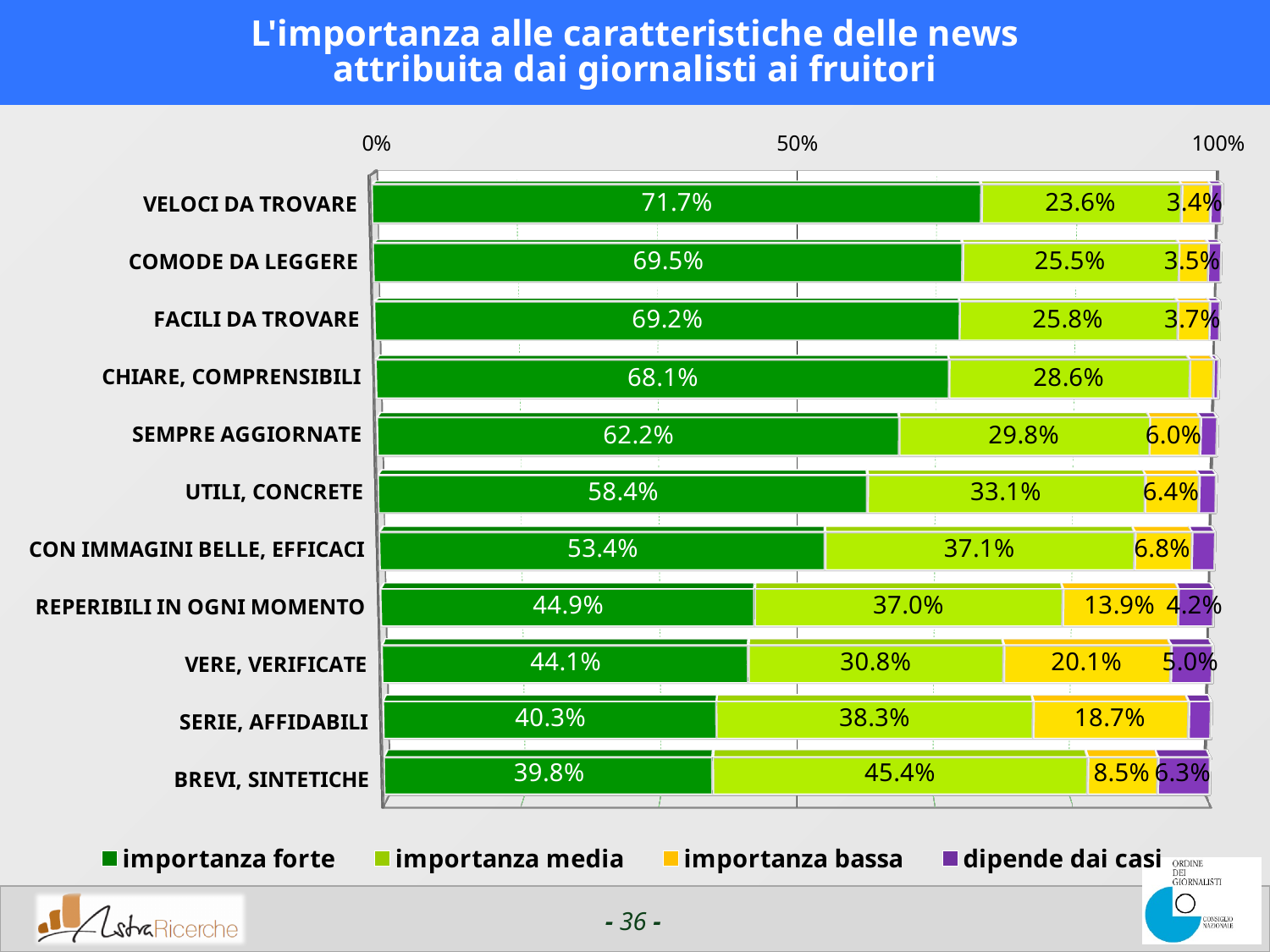
What is the value of "importanza forte" for VELOCI DA TROVARE? 71.7% Which category has the highest "importanza forte" value? VELOCI DA TROVARE Is the "importanza forte" value for SERIE, AFFIDABILI greater or less than 50%? less What is the value of "importanza media" for BREVI, SINTETICHE? 45.4% How many series does the legend list? 4 What is the difference between the "importanza forte" values for VELOCI DA TROVARE and COMODE DA LEGGERE? 2.2 percentage points Which category has the lowest "importanza forte" value? BREVI, SINTETICHE How many categories are shown on the chart? 11 What is the value of "importanza bassa" for VERE, VERIFICATE? 20.1% What kind of chart is shown on the slide? Stacked bar chart Which category has the highest "importanza media" value? BREVI, SINTETICHE Which has the larger "importanza media" value: UTILI, CONCRETE or SEMPRE AGGIORNATE? UTILI, CONCRETE